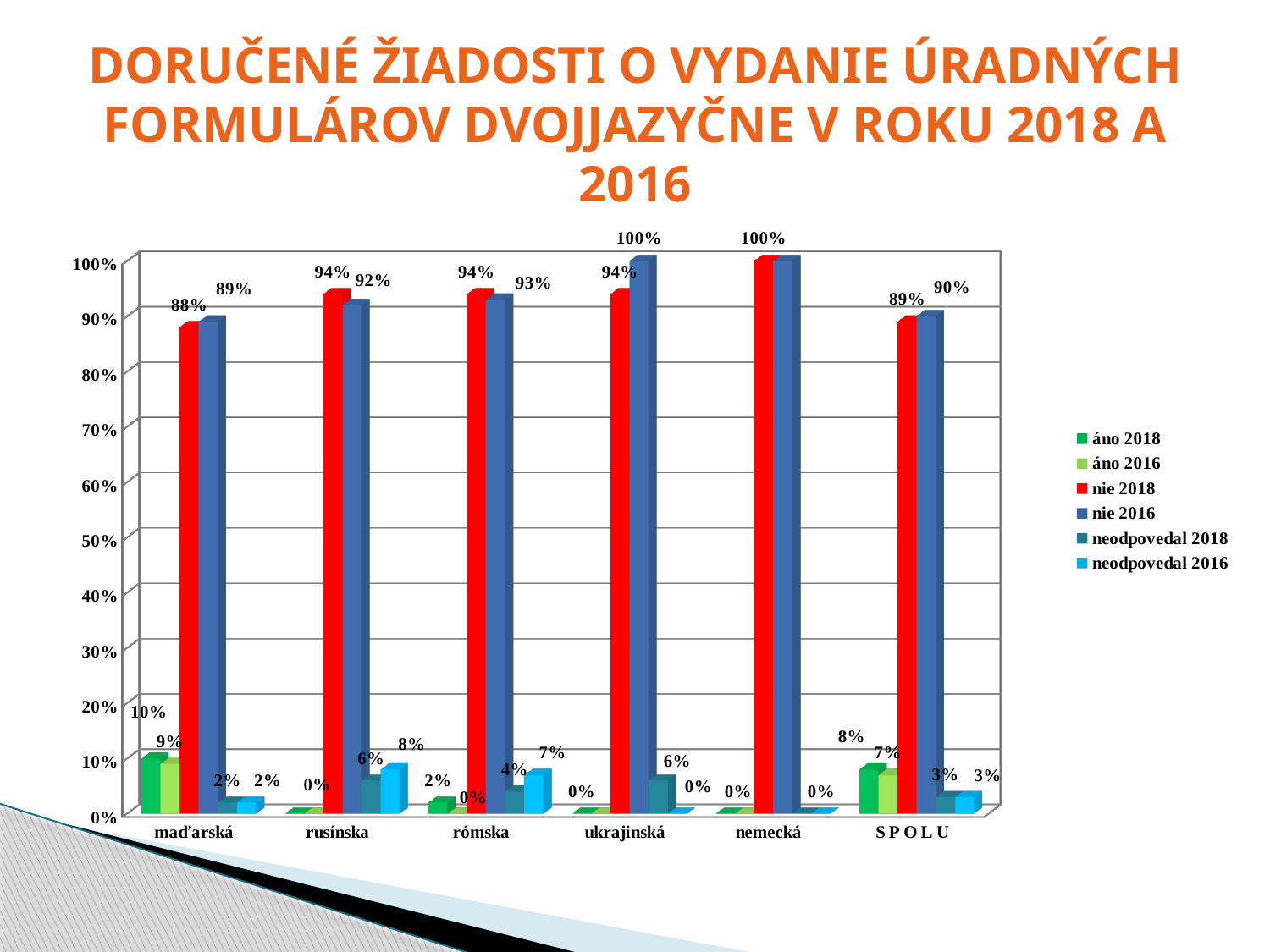
What kind of chart is shown on the slide? bar chart Which category has the highest value for áno 2018? maďarská What is the value of nie 2016 for ukrajinská? 100% Which is larger for rómska: neodpovedal 2016 or neodpovedal 2018? neodpovedal 2016 How many series does the legend list? 6 Which category has the highest value for nie 2018? nemecká What is the value of nie 2018 for maďarská? 88% What is the difference between nie 2016 and nie 2018 for S P O L U? 1% How many categories are shown on the x axis? 6 What is the value of neodpovedal 2016 for rusínska? 8% What is the value of áno 2018 for S P O L U? 8% What is the value of nie 2016 for rómska? 93%